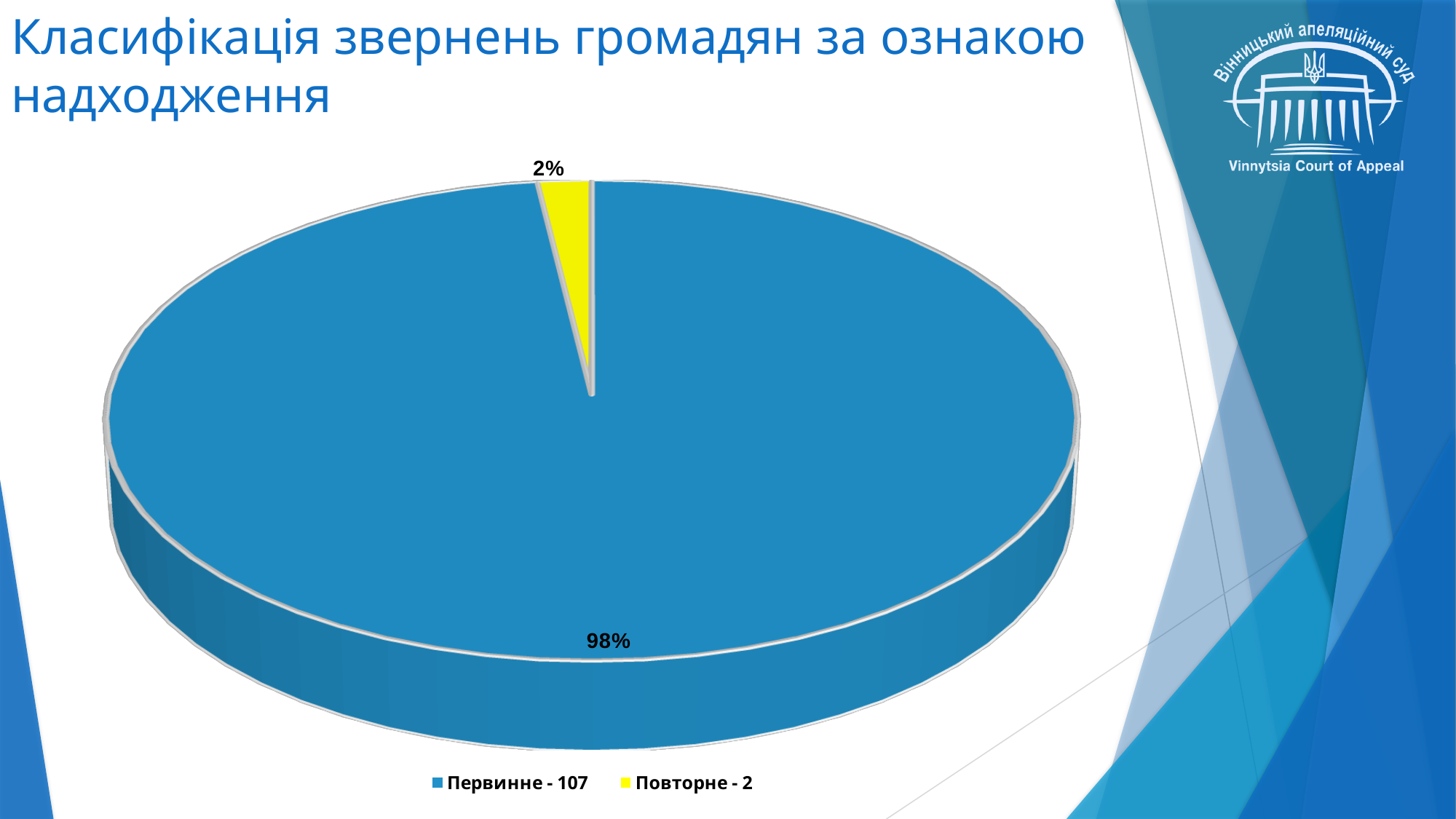
What is the difference in percentage points between the Первинне and Повторне slices? 96% How many entries does the legend list? 2 Which category has the smallest share of the pie? Повторне How many slices does the pie chart have? 2 What percentage share does the Первинне slice have? 98% What colour is the Повторне slice? yellow What kind of chart is shown on the slide? pie chart Which category has the largest share of the pie? Первинне What count is given for Повторне in the legend? 2 What count is given for Первинне in the legend? 107 Which is larger, the share for Первинне or the share for Повторне? Первинне What percentage share does the Повторне slice have? 2%